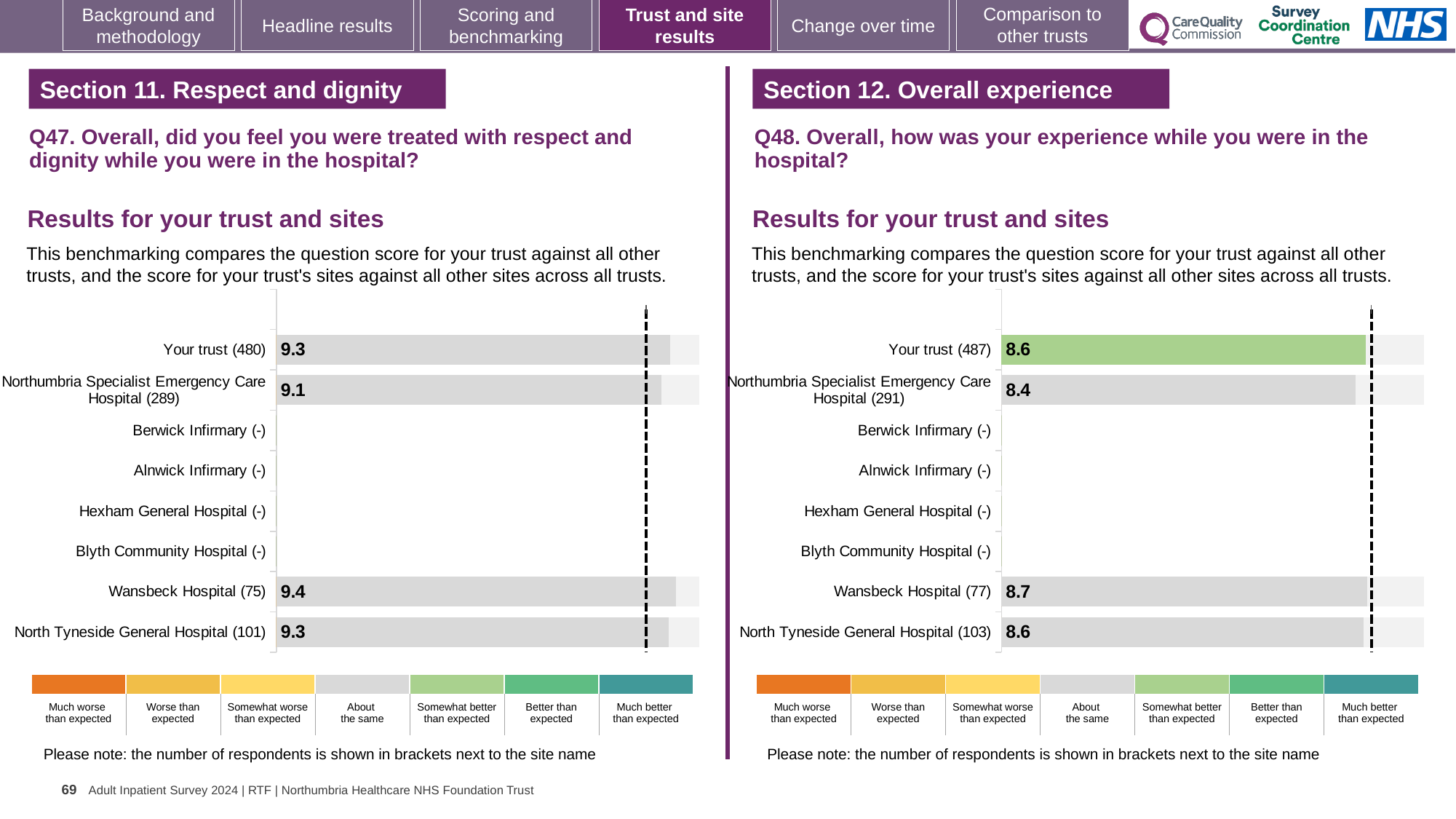
On the Q47 chart (left), what is the difference between the scores for Wansbeck Hospital and Northumbria Specialist Emergency Care Hospital? 0.3 What kind of chart is used on the Q47 chart (left)? Bar chart How many sites (including Your trust) are listed on the Q48 chart (right)? 8 On the Q48 chart (right), which site with a score shown has the lowest score? Northumbria Specialist Emergency Care Hospital On the Q47 chart (left), which site has the highest score? Wansbeck Hospital On the Q47 chart (left), which site with a score shown has the lowest score? Northumbria Specialist Emergency Care Hospital On the Q47 chart (left), what is the score for Your trust? 9.3 On the Q47 chart (left), what is the score for Northumbria Specialist Emergency Care Hospital? 9.1 On the Q48 chart (right), what is the score for Your trust? 8.6 On the Q48 chart (right), what is the score for Wansbeck Hospital? 8.7 On the Q48 chart (right), what is the difference between the scores for Your trust and Northumbria Specialist Emergency Care Hospital? 0.2 On the Q48 chart (right), which is larger: the score for Your trust or the score for Northumbria Specialist Emergency Care Hospital? Your trust